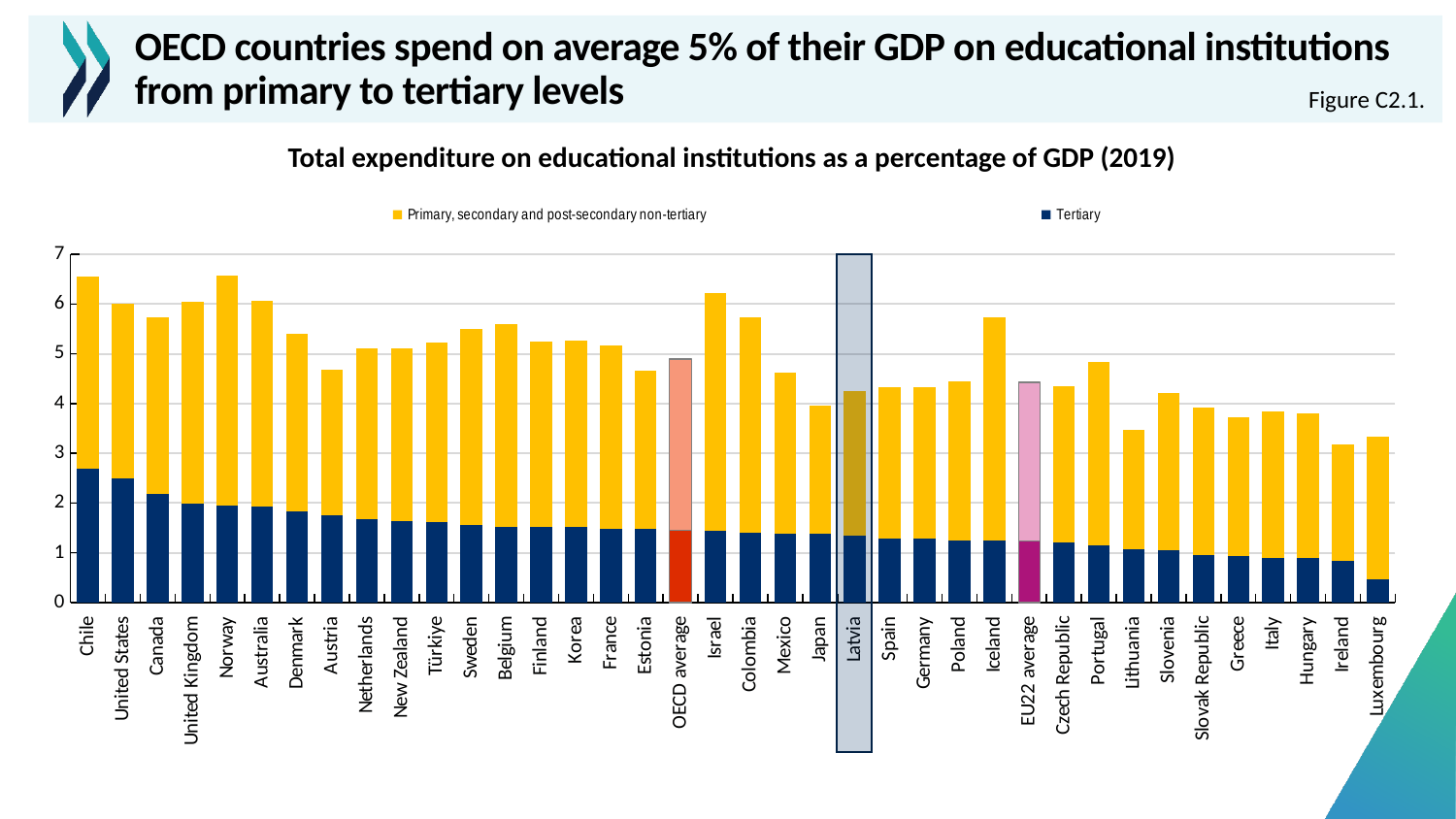
Which country is highlighted with a box on the chart? Latvia How many countries or averages are shown along the x axis? 38 Is the total value for the OECD average greater or less than 5? less Which country has the highest Tertiary value? Chile Which country has the lowest Tertiary value? Luxembourg What kind of chart is shown on the slide? Stacked bar chart Is the Tertiary value for Luxembourg greater or less than 1? less Is the total value for Iceland greater or less than 5? greater Which has the larger total value, Israel or Japan? Israel How many series does the legend list? 2